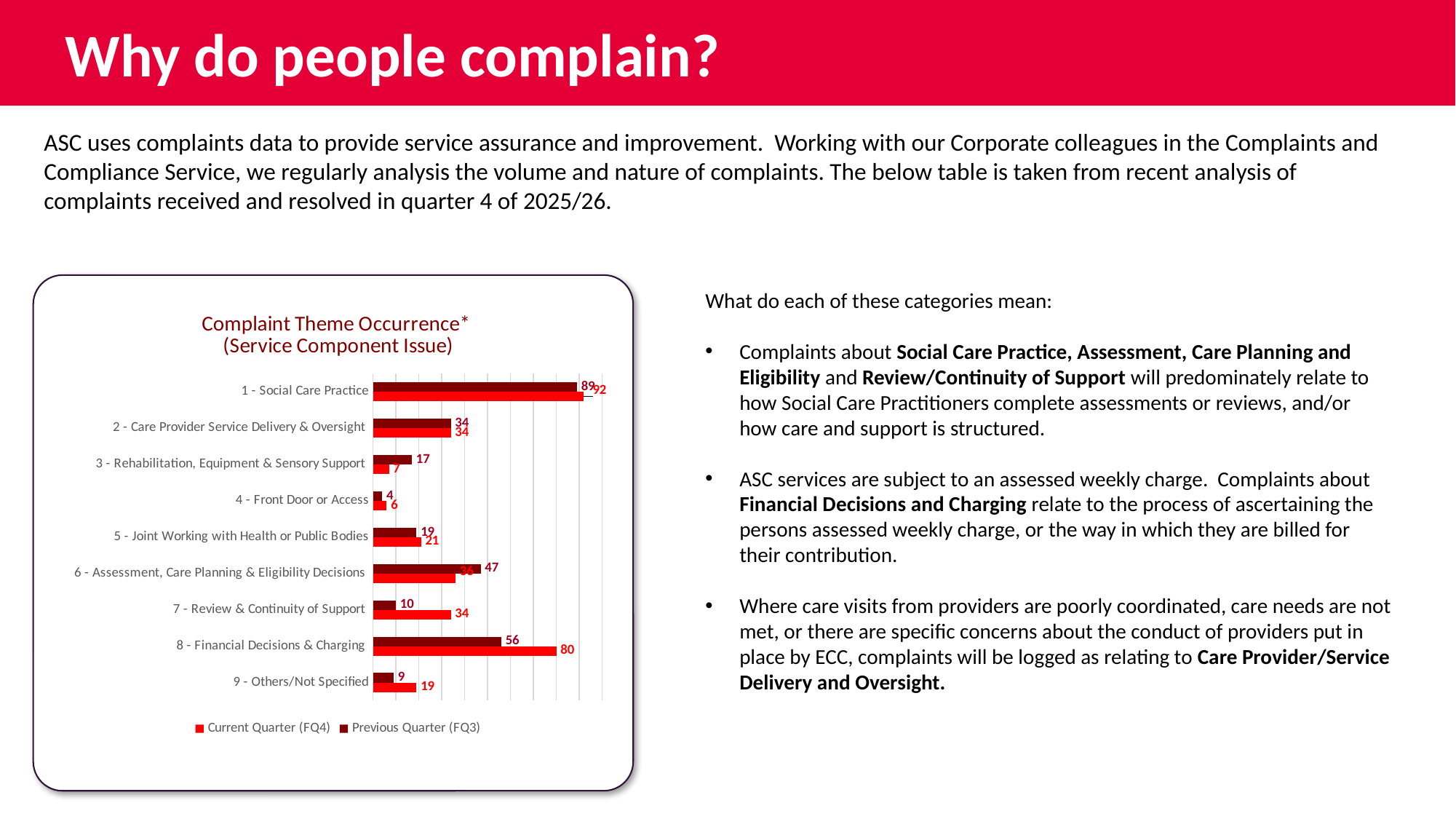
Which category has the lowest Previous Quarter (FQ3) value? 4 - Front Door or Access What type of chart is shown on the slide? bar chart How many complaint theme categories are plotted in the chart? 9 Which category has the highest Current Quarter (FQ4) value? 1 - Social Care Practice What is the Previous Quarter (FQ3) value for 9 - Others/Not Specified? 9 What is the Current Quarter (FQ4) value for 8 - Financial Decisions & Charging? 80 Which series is shown in bright red in the chart? Current Quarter (FQ4) What is the Current Quarter (FQ4) value for 7 - Review & Continuity of Support? 34 How many series does the legend list in the Complaint Theme Occurrence chart? 2 For 3 - Rehabilitation, Equipment & Sensory Support, which is larger: the Current Quarter (FQ4) value or the Previous Quarter (FQ3) value? Previous Quarter (FQ3) What is the difference between the Current Quarter (FQ4) and Previous Quarter (FQ3) values for 8 - Financial Decisions & Charging? 24 What is the Previous Quarter (FQ3) value for 6 - Assessment, Care Planning & Eligibility Decisions? 47